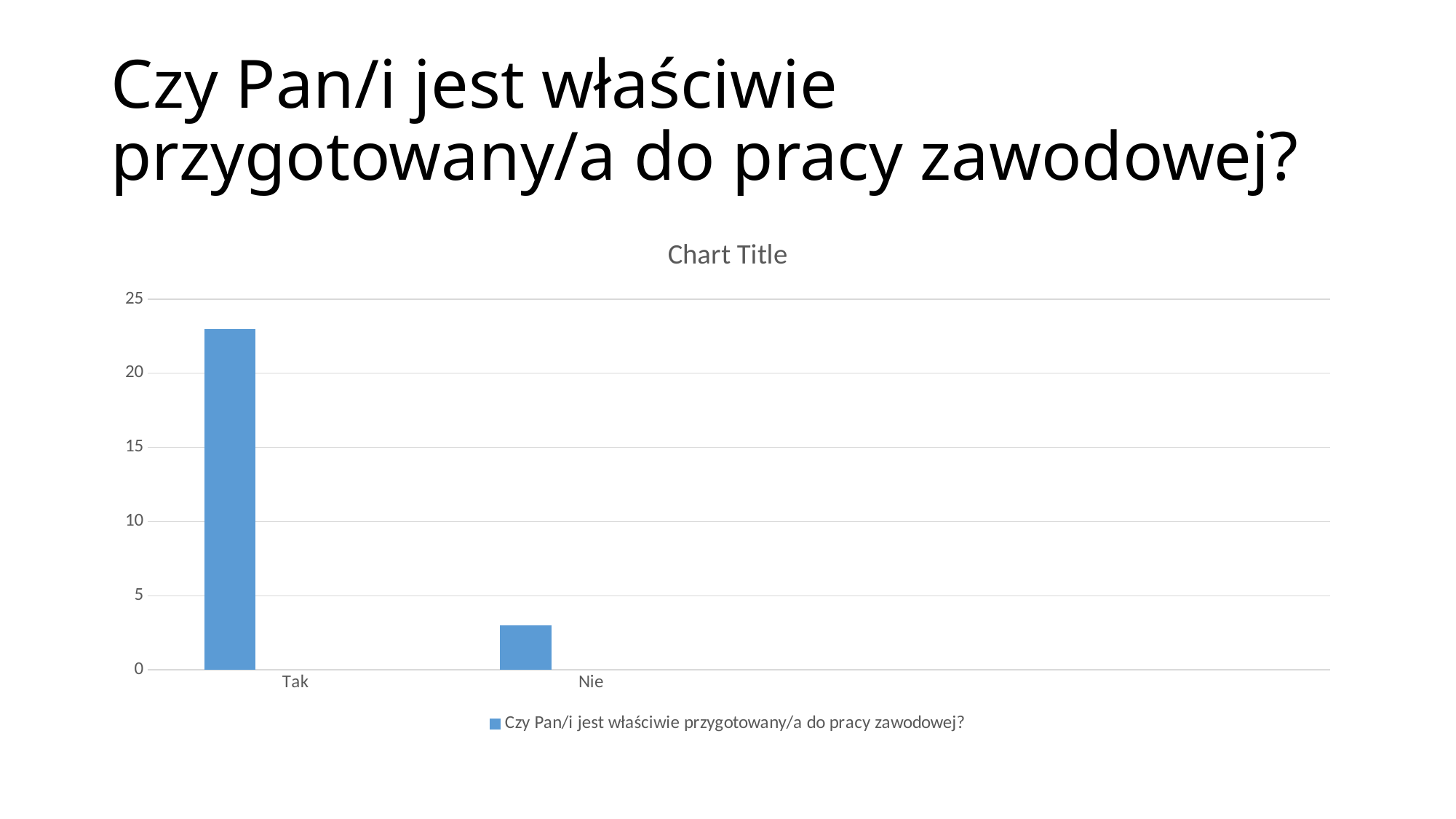
Is the value for Nie greater or less than 5? less How many categories are shown on the x axis? 2 How many series does the legend list? 1 Is the value for Tak greater or less than 20? greater What is the title shown above the chart? Chart Title What is the highest value shown on the y axis? 25 What kind of chart is shown on the slide? bar chart Which is larger, the value for Tak or the value for Nie? Tak Which category has the highest value? Tak Which category has the lowest value? Nie What is the legend entry for the series? Czy Pan/i jest właściwie przygotowany/a do pracy zawodowej? Is the value for Tak greater or less than 25? less